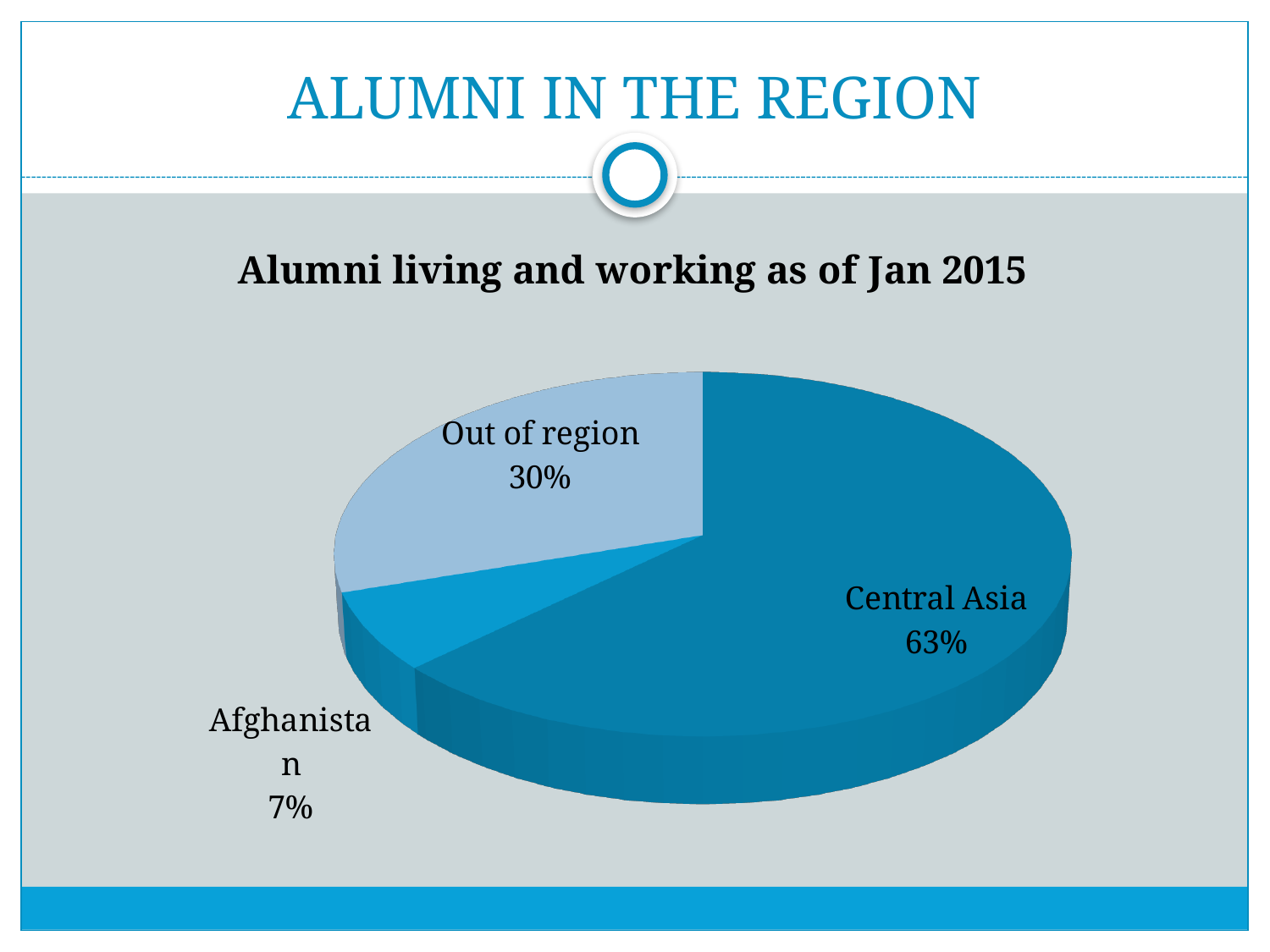
Which category is shown in the lightest blue slice? Out of region What kind of chart is shown on the slide? Pie chart How many categories does the pie chart show? 3 What share of alumni are out of region? 30% What share of alumni are in Central Asia? 63% What is the difference in percentage points between Out of region and Afghanistan? 23 percentage points Which category has the smallest share of alumni? Afghanistan Which category has the largest share of alumni? Central Asia What is the title of the chart? Alumni living and working as of Jan 2015 Which is larger, the share for Out of region or the share for Afghanistan? Out of region What share of alumni are in Afghanistan? 7% What is the difference in percentage points between Central Asia and Out of region? 33 percentage points